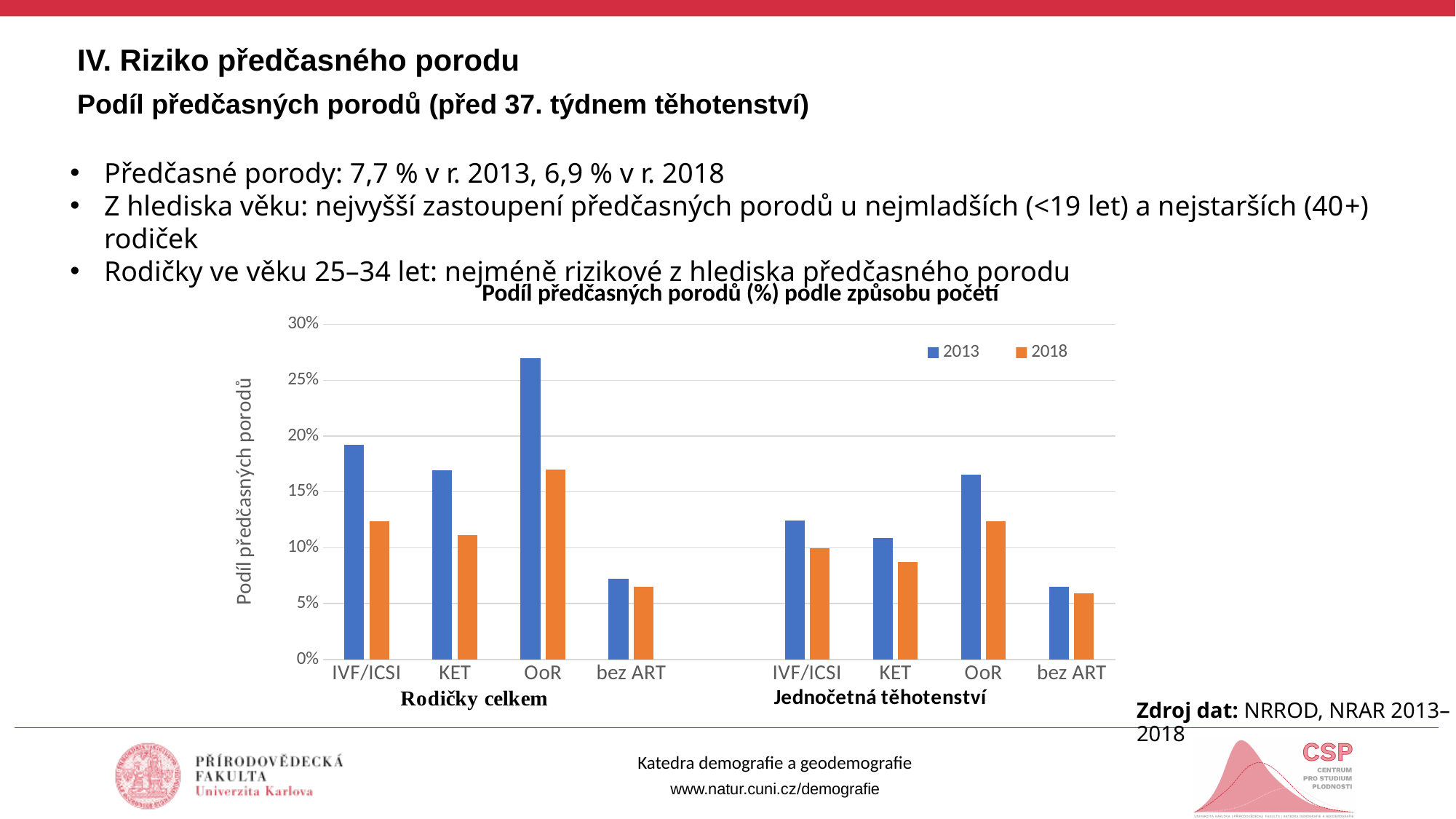
Which category and year has the lowest bar in the chart? bez ART, 2018 (Jednočetná těhotenství) How many categories are in the 'Rodičky celkem' group of the chart? 4 Is the 2013 value for IVF/ICSI in the 'Rodičky celkem' group greater or less than 15%? greater Is the 2013 value for bez ART in the 'Jednočetná těhotenství' group greater or less than 10%? less What kind of chart is shown on the slide? bar chart For KET in the 'Rodičky celkem' group, which year has the larger value, 2013 or 2018? 2013 What colour represents the year 2018 in the chart? orange How many categories are shown on the x axis of the chart in total? 8 How many series does the legend of the chart list? 2 Which is larger: the 2013 value for IVF/ICSI in 'Rodičky celkem' or the 2013 value for IVF/ICSI in 'Jednočetná těhotenství'? Rodičky celkem Which category and year has the highest bar in the chart? OoR, 2013 (Rodičky celkem) Is the 2013 value for OoR in the 'Rodičky celkem' group greater or less than 25%? greater